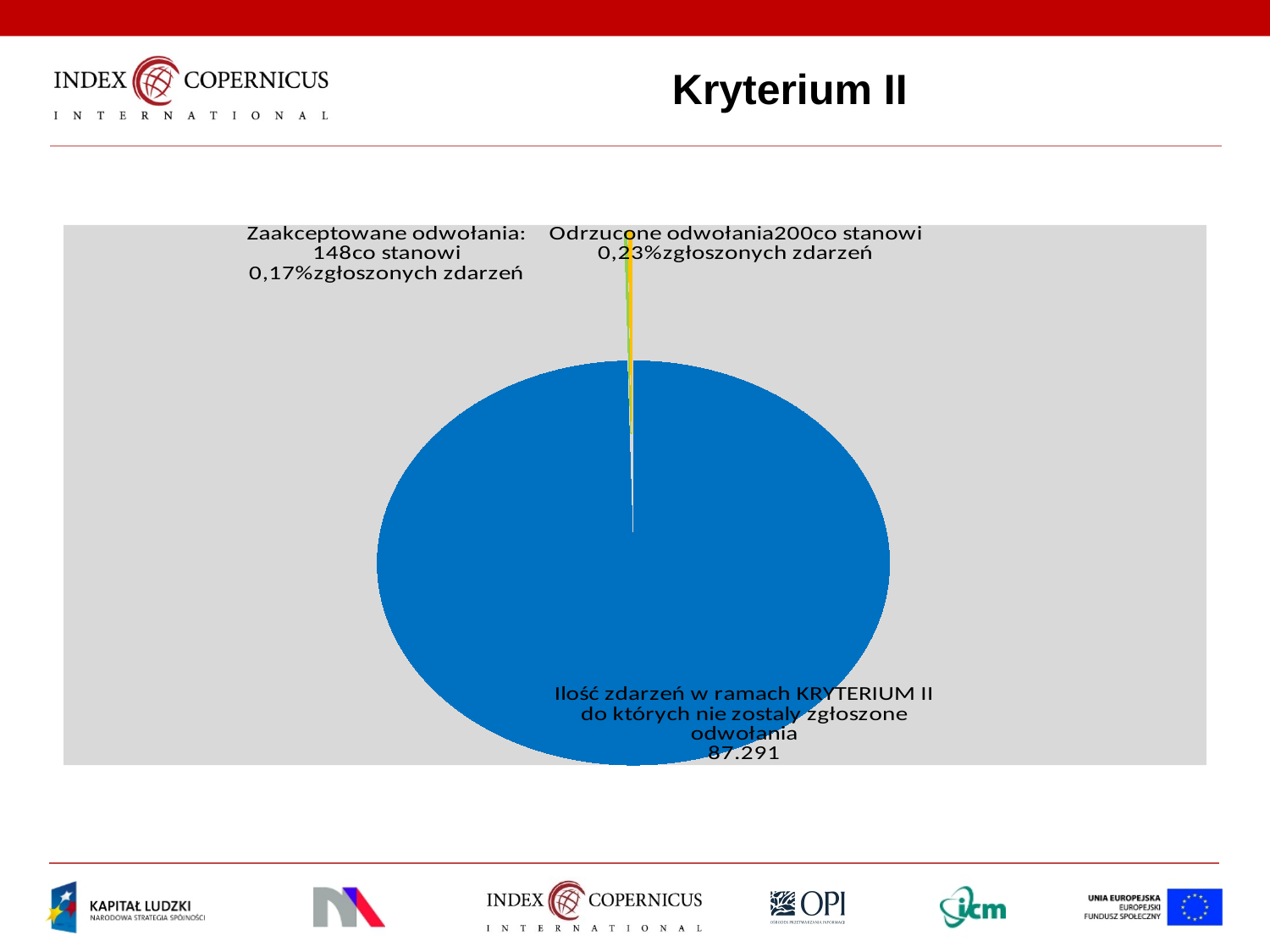
Which category has the smallest slice of the pie? Zaakceptowane odwołania What is the title of the slide containing the pie chart? Kryterium II What share of reported events do the rejected appeals (Odrzucone odwołania) represent, according to the label? 0,23% What is the difference between the number of rejected appeals (200) and accepted appeals (148)? 52 What is the value for 'Zaakceptowane odwołania'? 148 Which is larger: the number of accepted appeals (Zaakceptowane odwołania) or rejected appeals (Odrzucone odwołania)? Odrzucone odwołania What kind of chart is shown on the slide? pie chart How many slices does the pie chart have? 3 Which category has the largest slice of the pie? Ilość zdarzeń w ramach KRYTERIUM II do których nie zostały zgłoszone odwołania What is the value for 'Ilość zdarzeń w ramach KRYTERIUM II do których nie zostały zgłoszone odwołania'? 87.291 What is the value for 'Odrzucone odwołania'? 200 What share of reported events do the accepted appeals (Zaakceptowane odwołania) represent, according to the label? 0,17%